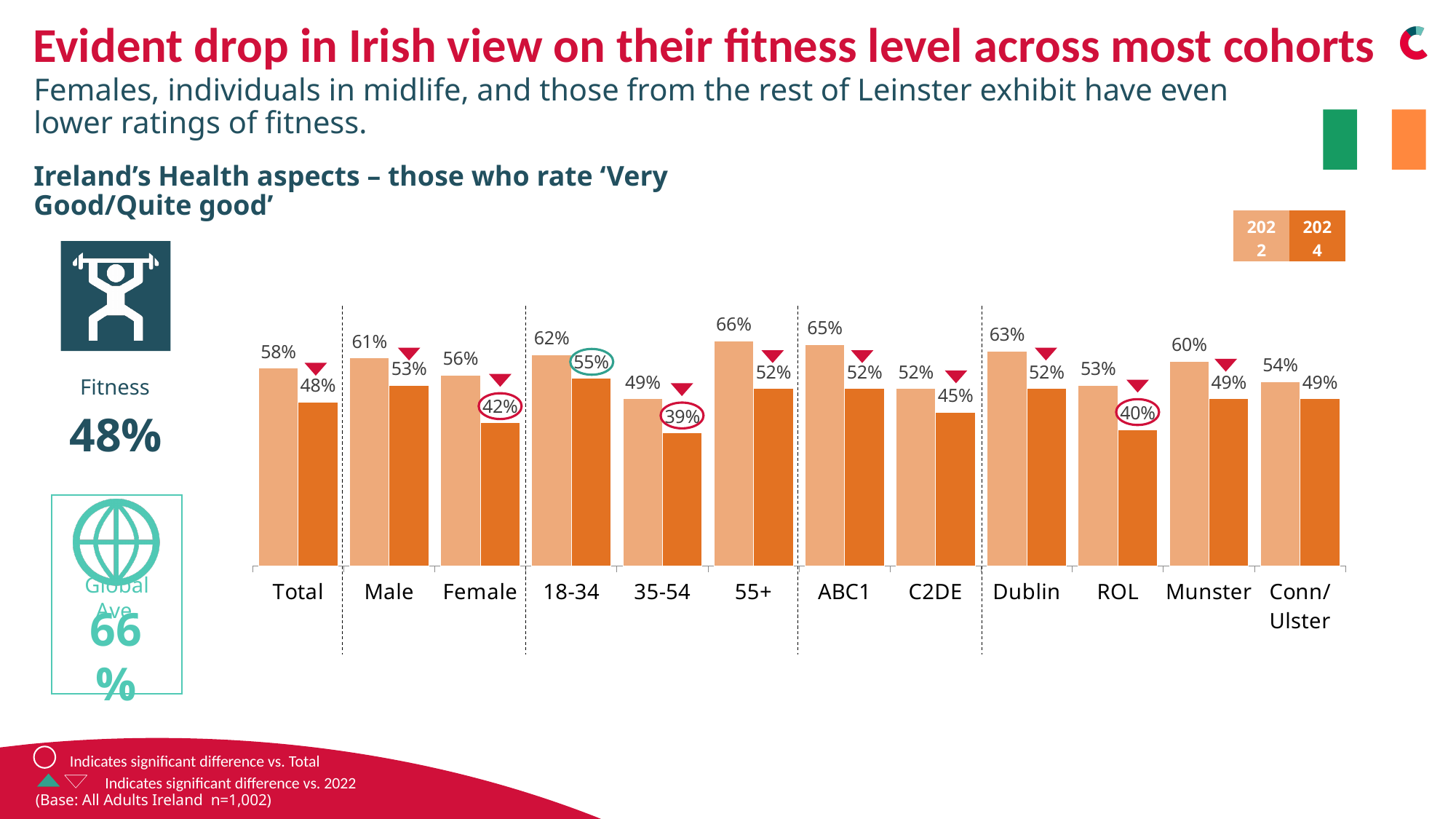
How many categories are shown on the x axis? 12 What is the 2024 value for Female? 42% What is the 2024 value for ROL? 40% What is the 2022 value for 55+? 66% Which is larger, the 2024 value for Male or the 2024 value for Female? Male What kind of chart is shown on the slide? Bar chart Which category has the lowest 2024 value? 35-54 What are the two years shown in the legend? 2022 and 2024 What is the difference between the 2022 and 2024 values for Female? 14% How many series does the legend list? 2 Which category has the highest 2022 value? 55+ What is the difference between the 2022 and 2024 values for Total? 10%